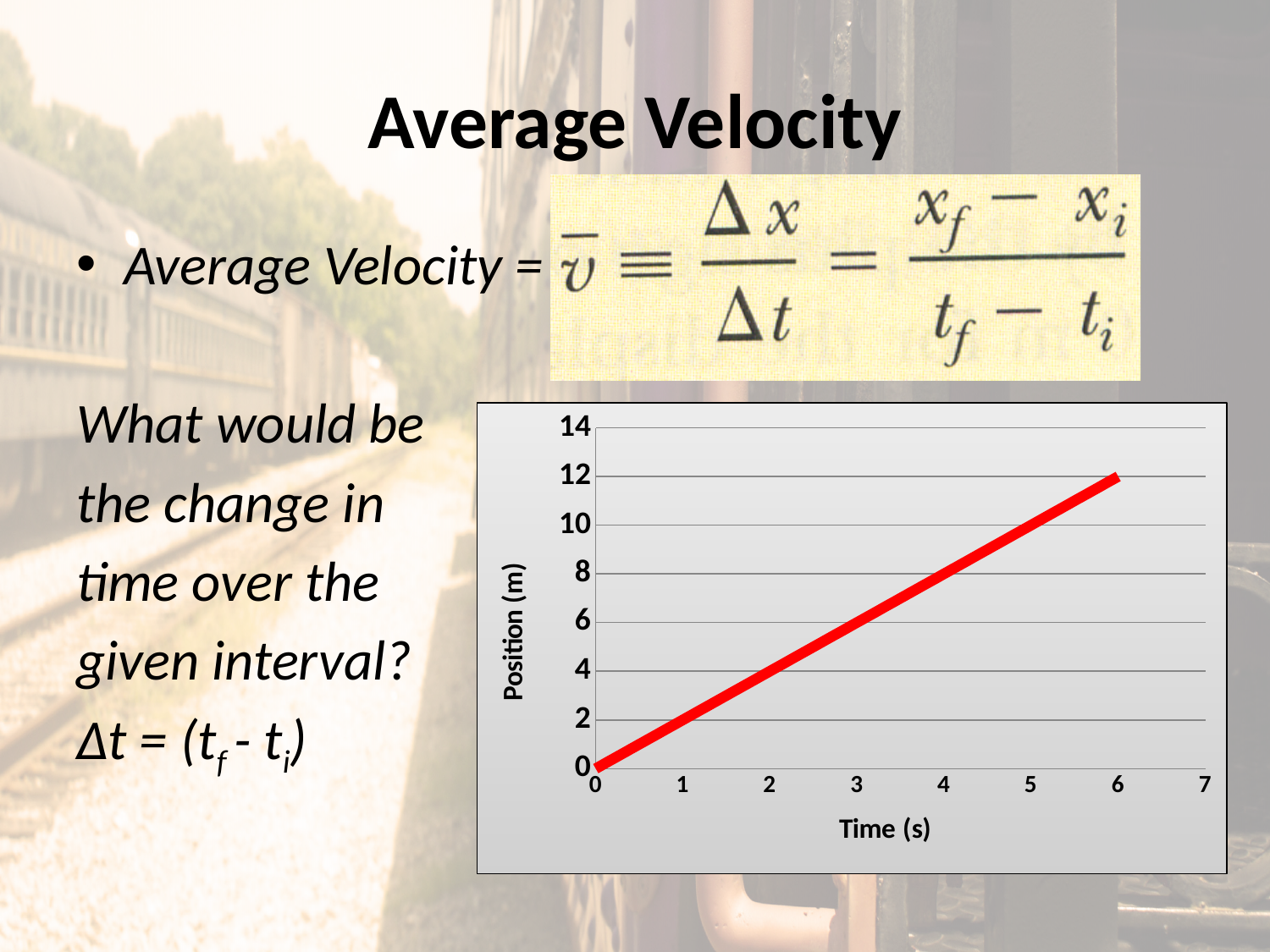
What is the position at time 0 s, where the red line starts? 0 What is the label of the horizontal axis of the chart? Time (s) Does the position rise or fall as time increases along the x axis? rise Which is larger, the position at time 1 s or the position at time 5 s? time 5 s Is the position at time 2 s greater or less than 6? less What is the label of the vertical axis of the chart? Position (m) Is the position at time 4 s greater or less than 10? less Is the position at time 5 s greater or less than 8? greater What kind of chart is shown on the slide? line chart What is the position at time 6 s, where the red line ends? 12 What is the highest value shown on the vertical axis? 14